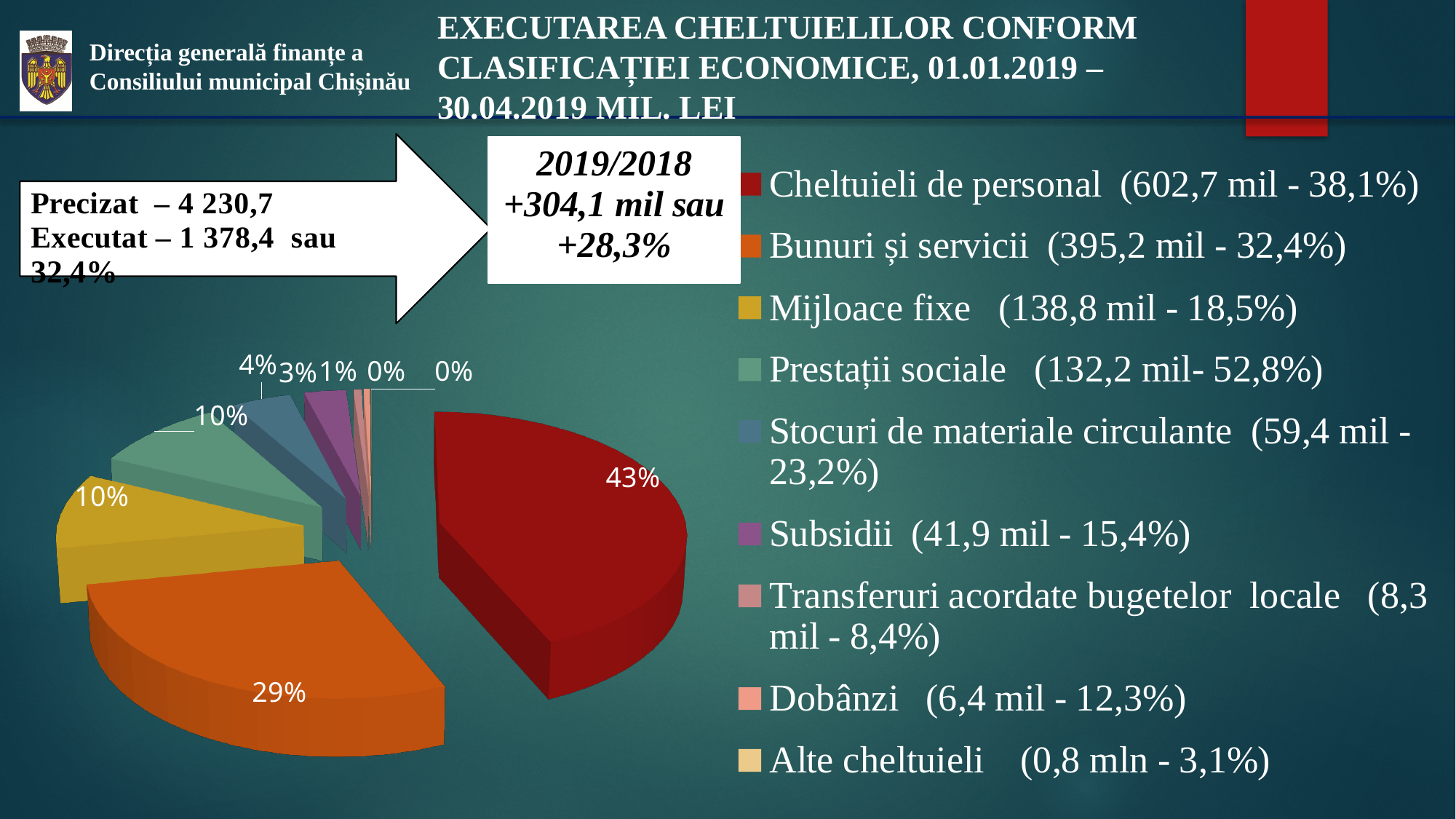
What kind of chart is shown on the slide? pie chart What share of the pie does Cheltuieli de personal represent? 43% How many slices does the pie chart have? 9 Which category has the largest slice of the pie? Cheltuieli de personal Which slice is larger, Bunuri și servicii or Mijloace fixe? Bunuri și servicii How many entries does the legend list? 9 What percentage is labelled on the Stocuri de materiale circulante slice? 4% What percentage is labelled on the Subsidii slice? 3% What percentage is labelled on the Bunuri și servicii slice? 29% What amount and percentage does the legend show for Mijloace fixe? 138,8 mil - 18,5% What colour is the largest slice of the pie? red By how many percentage points does the Cheltuieli de personal slice exceed the Bunuri și servicii slice? 14 percentage points